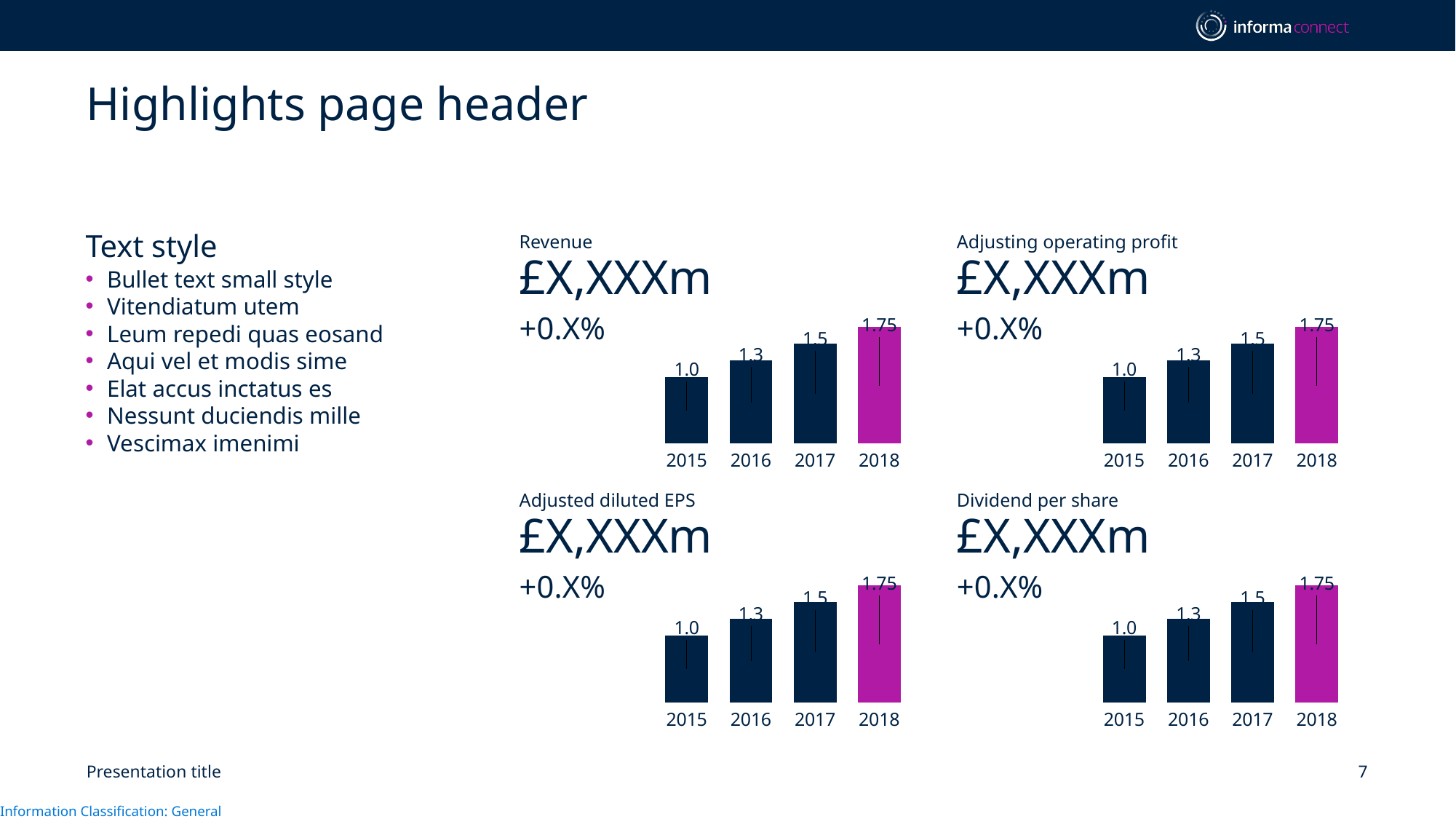
In the Revenue chart, which year has the highest value? 2018 In the Dividend per share chart, what is the value for 2016? 1.3 In the Dividend per share chart, which year has the lowest value? 2015 In the Revenue chart, what is the value for 2017? 1.5 In the Revenue chart, which is larger, the value for 2016 or the value for 2017? 2017 In the Adjusted diluted EPS chart, what is the difference between the 2016 and 2015 values? 0.3 How many years are shown in the Dividend per share chart? 4 In the Adjusting operating profit chart, what is the difference between the 2018 and 2017 values? 0.25 In the Adjusting operating profit chart, do the values rise or fall from 2015 to 2018? Rise In the Adjusted diluted EPS chart, what is the value for 2018? 1.75 In the Adjusting operating profit chart, what is the value for 2015? 1.0 What type of chart is the Adjusted diluted EPS chart? Bar chart